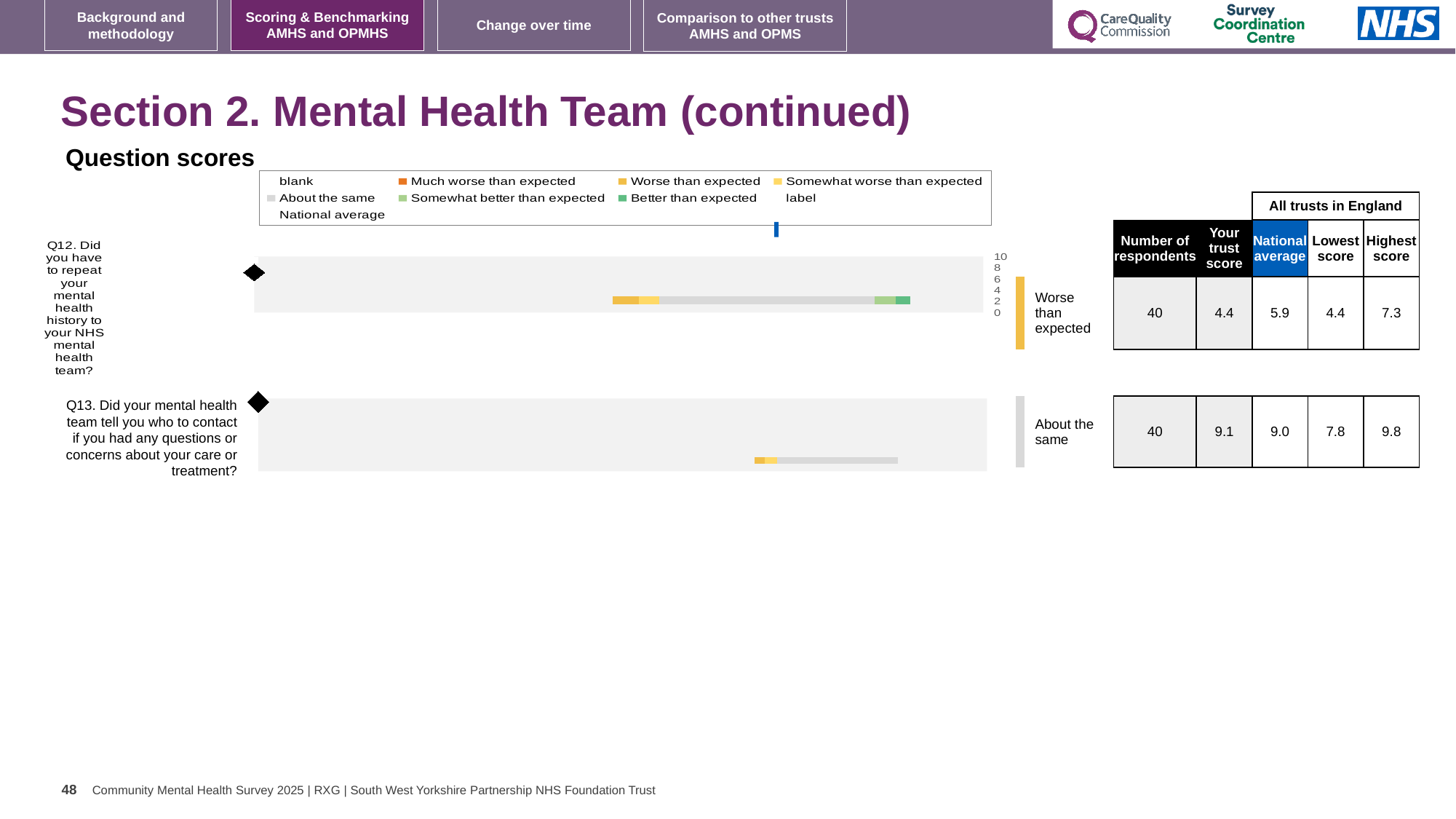
How many questions are plotted in the question scores chart? 2 What is the trust score for Q12 in the question scores table? 4.4 Which is larger for Q12: the trust score or the national average? national average What is the benchmark category shown for Q12 in the question scores chart? Worse than expected What is the difference between the highest score and the lowest score for Q12? 2.9 What is the highest score across all trusts in England for Q12? 7.3 What is the national average for Q13 in the question scores table? 9.0 What kind of chart is used to show the question scores on this slide? bar chart What is the difference between the trust score and the national average for Q13? 0.1 What is the benchmark category shown for Q13 in the question scores chart? About the same How many respondents answered Q13? 40 Which question has the higher trust score, Q12 or Q13? Q13